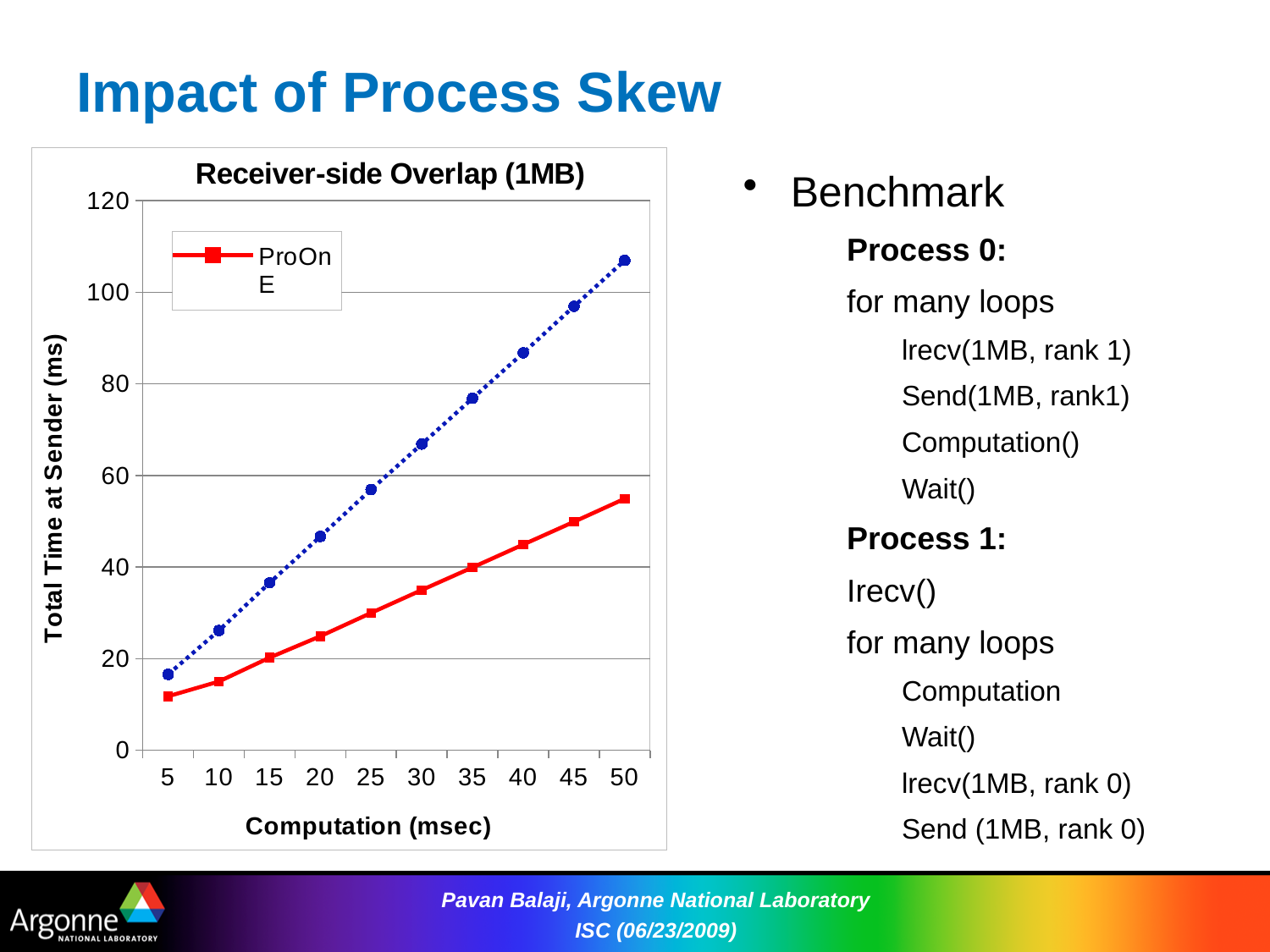
Is the value of the blue dotted line at Computation 50 msec greater or less than 100? greater What kind of chart is shown on the slide? line chart What is the title of the chart? Receiver-side Overlap (1MB) At Computation 50 msec, which line has the higher total time: ProOnE or the blue dotted line? the blue dotted line How many data points are plotted along the x axis for the ProOnE series? 10 What is the label of the y axis? Total Time at Sender (ms) Is the ProOnE value at Computation 40 msec greater or less than 60? less Does the blue dotted line rise or fall as Computation increases along the x axis? rise Is the value of the blue dotted line at Computation 30 msec greater or less than 60? greater Does the ProOnE total time rise or fall as Computation increases from 5 to 50 msec? rise